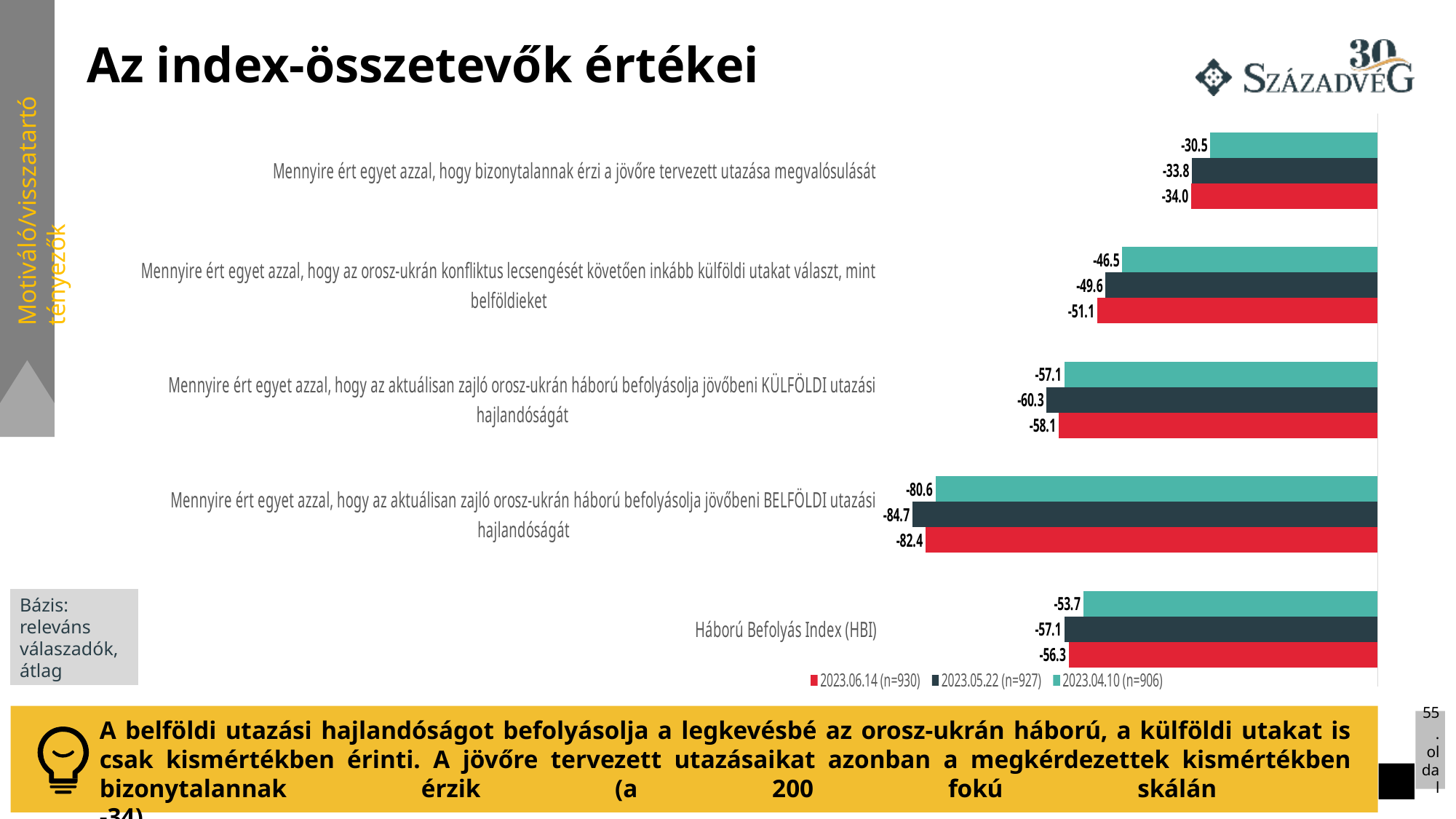
How many categories (statements) are shown in the chart? 5 What type of chart is shown on the slide? Bar chart Which category has the lowest (most negative) value in the 2023.05.22 (n=927) series? Mennyire ért egyet azzal, hogy az aktuálisan zajló orosz-ukrán háború befolyásolja jövőbeni BELFÖLDI utazási hajlandóságát For the statement about the war influencing future KÜLFÖLDI travel willingness, which series has the larger (less negative) value: 2023.06.14 or 2023.05.22? 2023.06.14 (n=930) What is the difference between the 2023.05.22 and 2023.04.10 values for the statement about the war influencing future BELFÖLDI travel willingness? 4.1 What is the 2023.04.10 (n=906) value for the statement about the war influencing future BELFÖLDI (domestic) travel willingness? -80.6 What is the 2023.06.14 (n=930) value for the statement about choosing foreign trips rather than domestic ones after the conflict subsides? -51.1 What is the difference between the 2023.05.22 and 2023.06.14 values of the Háború Befolyás Index (HBI)? 0.8 What is the value of the Háború Befolyás Index (HBI) for the 2023.06.14 (n=930) series? -56.3 How many series does the legend list? 3 What is the 2023.05.22 (n=927) value for the statement about feeling uncertain that the trip planned for next year will be realised? -33.8 Which category has the highest (least negative) value in the 2023.04.10 (n=906) series? Mennyire ért egyet azzal, hogy bizonytalannak érzi a jövőre tervezett utazása megvalósulását